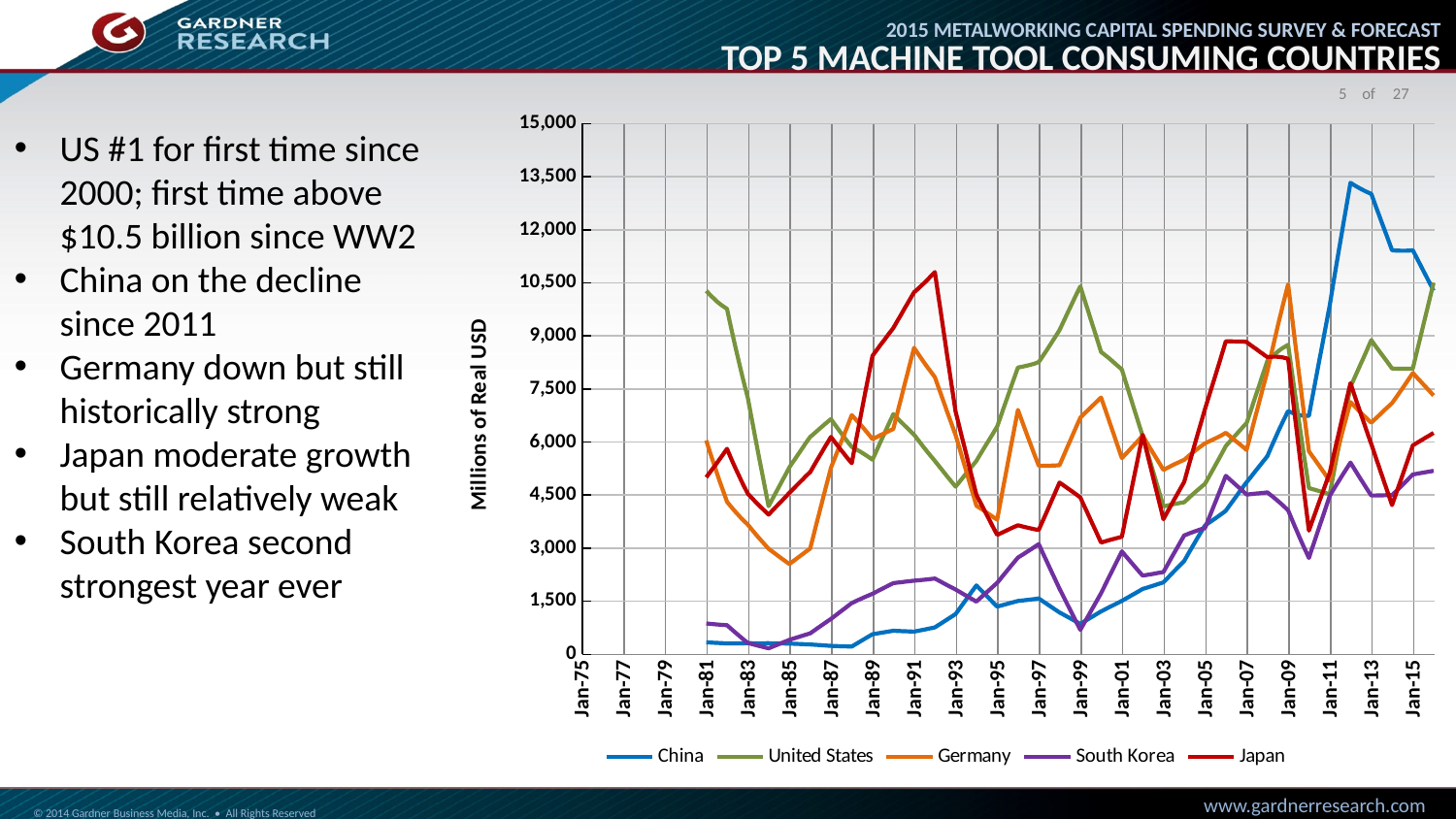
At Jan-15, which is larger, the value for United States or the value for Germany? United States At Jan-91, which is larger, the value for Japan or the value for Germany? Japan Is the value for South Korea at Jan-85 greater or less than 1,500? less How many series does the chart legend list? 5 What kind of chart is shown on the slide? line chart Is the value for Japan at Jan-95 greater or less than 4,500? less Does the value for China rise or fall from Jan-11 to Jan-15? fall Is the value for United States at Jan-99 greater or less than 9,000? greater Which series is listed first in the chart legend? China What is the title of the vertical axis of the chart? Millions of Real USD Which series reaches the highest value anywhere on the chart? China